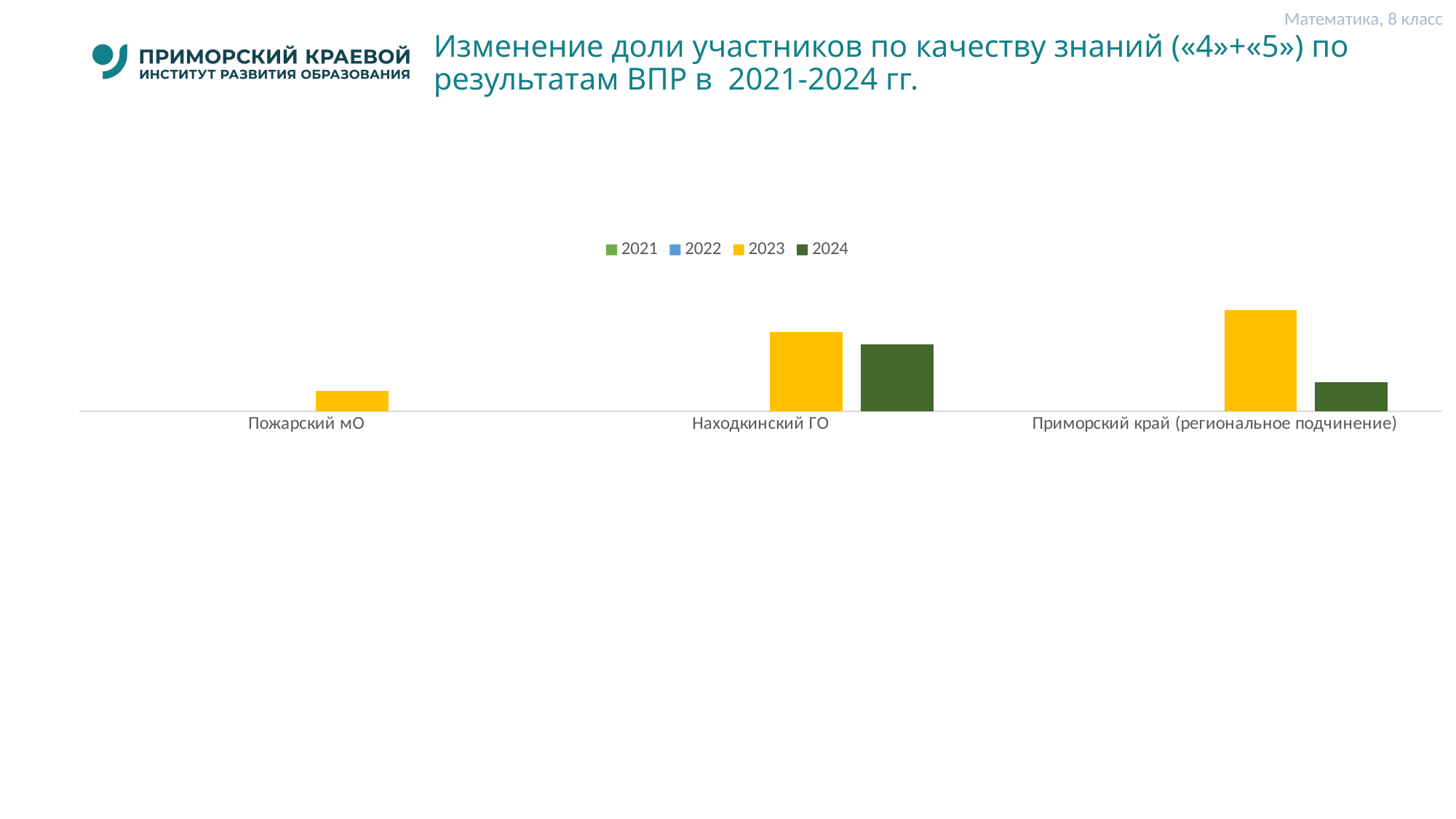
Which years are listed in the chart legend? 2021, 2022, 2023, 2024 What kind of chart is shown on the slide? bar chart For Приморский край (региональное подчинение), which is larger: the 2023 value or the 2024 value? 2023 Which has the larger 2024 value: Находкинский ГО or Приморский край (региональное подчинение)? Находкинский ГО Which category has the lowest 2023 bar? Пожарский мО How many series does the legend list? 4 How many categories are shown on the x axis? 3 Which has the larger 2023 value: Пожарский мО or Находкинский ГО? Находкинский ГО Which category has the highest 2023 bar? Приморский край (региональное подчинение) What colour are the 2023 bars? yellow